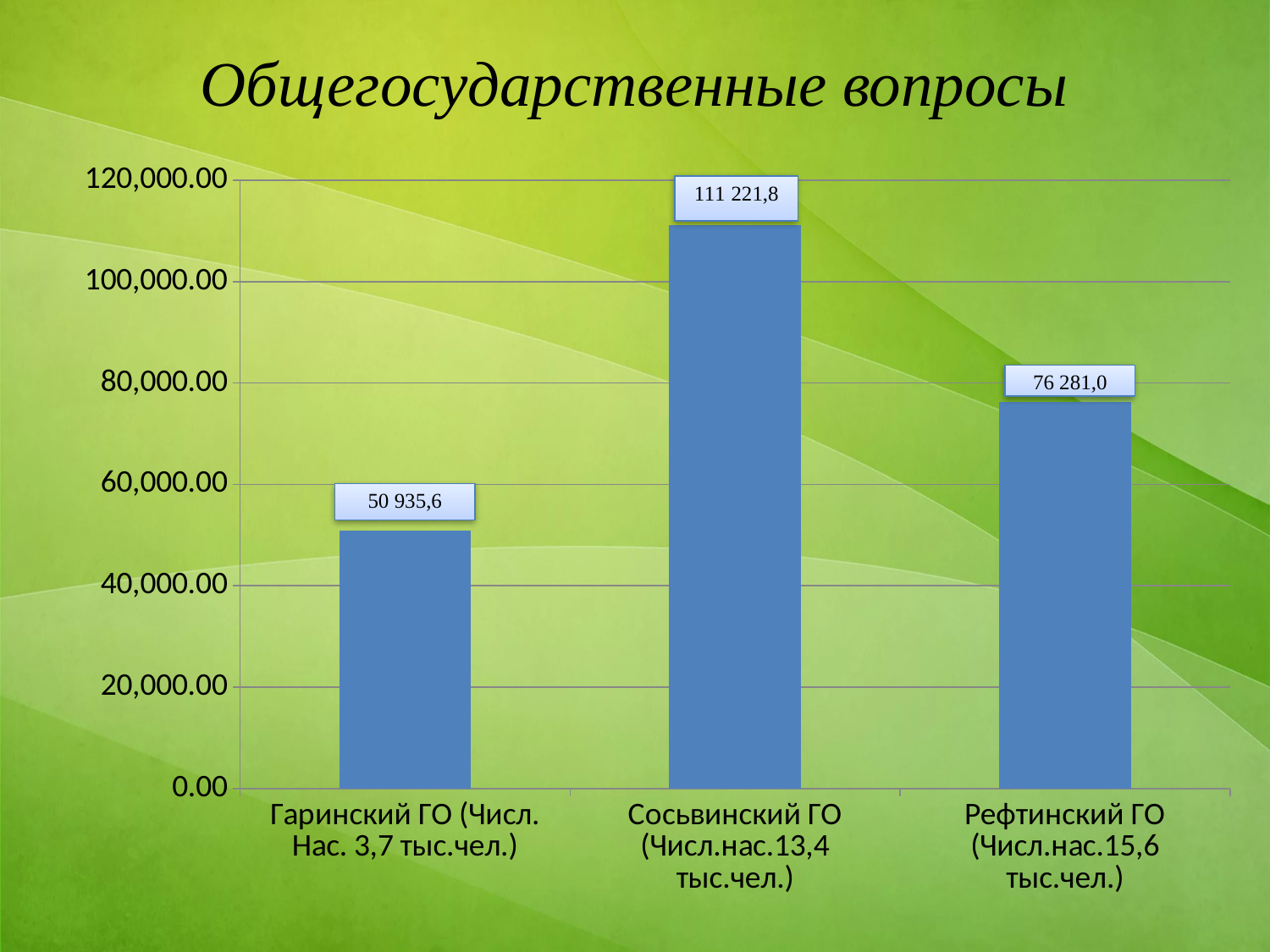
What is the title of the slide? Общегосударственные вопросы What kind of chart is shown on the slide? bar chart What is the difference between the values for Рефтинский ГО and Гаринский ГО? 25 345,4 What is the value shown for Рефтинский ГО? 76 281,0 Is the value for Сосьвинский ГО greater or less than 100,000.00? greater What is the value shown for Сосьвинский ГО? 111 221,8 What is the value shown for Гаринский ГО? 50 935,6 Which is larger, the value for Рефтинский ГО or the value for Гаринский ГО? Рефтинский ГО Which category has the lowest value? Гаринский ГО What is the difference between the values for Сосьвинский ГО and Гаринский ГО? 60 286,2 How many categories are shown on the chart? 3 Which category has the highest value? Сосьвинский ГО